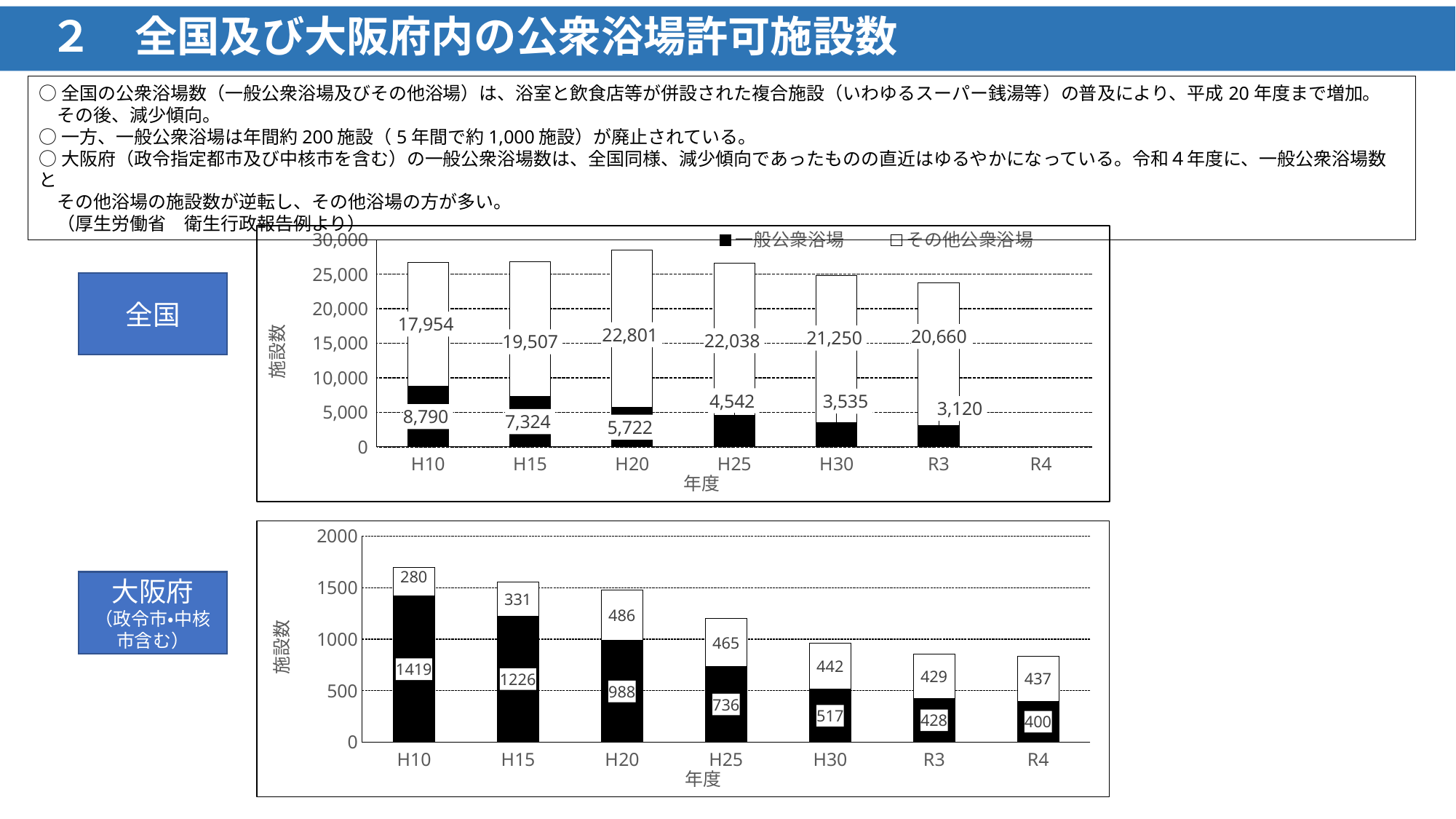
In the 全国 chart (top), what is the value of その他公衆浴場 for H20? 22,801 In the 全国 chart (top), does the value of 一般公衆浴場 rise or fall from H10 to R3? fall In the 全国 chart (top), how many series does the legend list? 2 In the 大阪府 chart (bottom), what is the difference between 一般公衆浴場 for H10 and for R4? 1019 In the 全国 chart (top), what is the value of 一般公衆浴場 for H10? 8,790 In the 大阪府 chart (bottom), what is the value of 一般公衆浴場 for H25? 736 In the 全国 chart (top), which year has the lowest value for 一般公衆浴場? R3 In the 大阪府 chart (bottom), which is larger for R4: 一般公衆浴場 or その他公衆浴場? その他公衆浴場 In the 大阪府 chart (bottom), what is the value of その他公衆浴場 for R4? 437 In the 全国 chart (top), which year has the highest value for その他公衆浴場? H20 In the 全国 chart (top), what is the total of the stacked bar for R3? 23,780 What kind of chart is the 大阪府 chart (bottom)? stacked bar chart